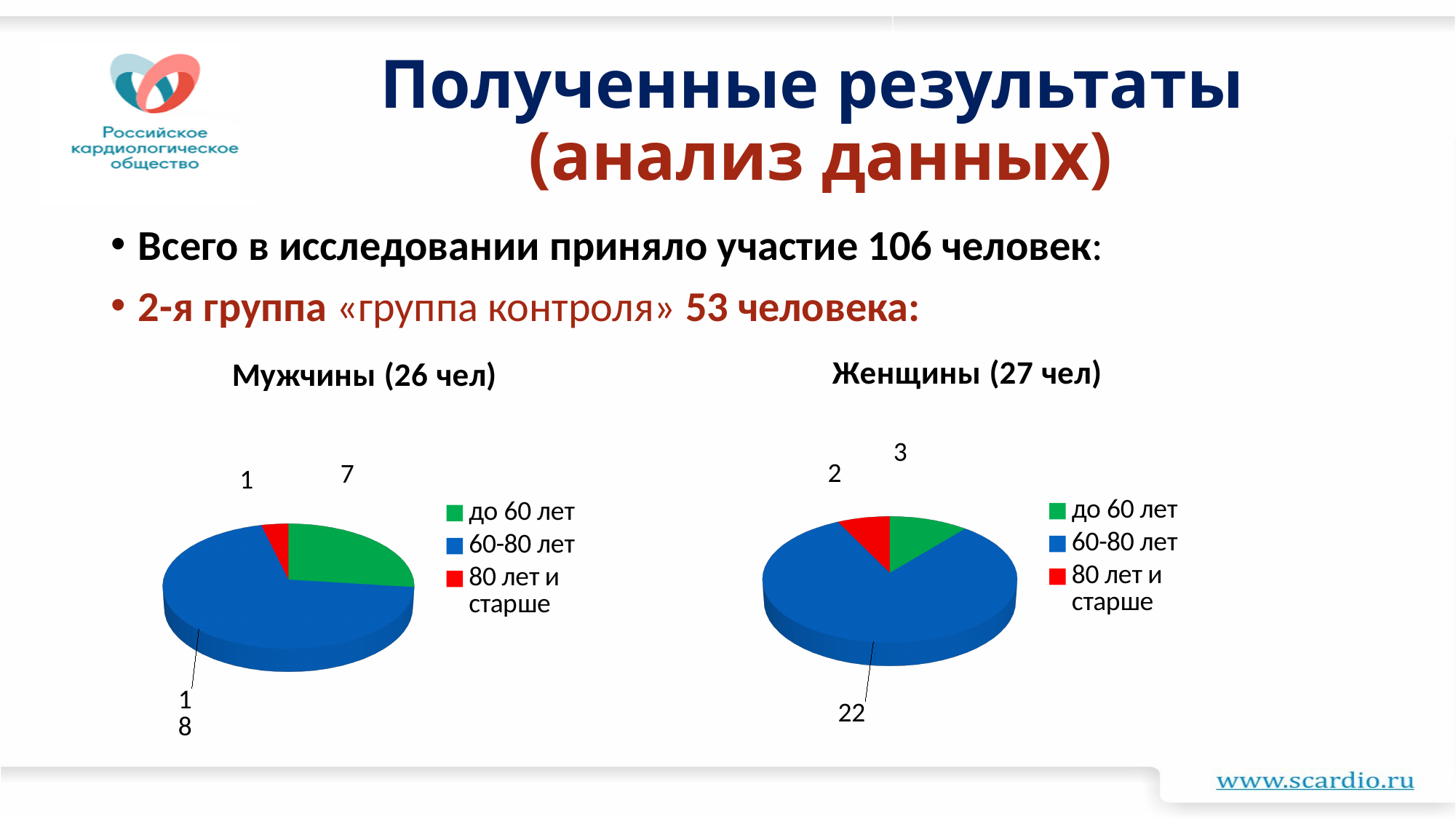
In the 'Женщины (27 чел)' chart, which age group has the smallest slice? 80 лет и старше In the 'Мужчины (26 чел)' chart, which age group has the largest slice? 60-80 лет Which is larger: the 'до 60 лет' value in the 'Мужчины (26 чел)' chart or the 'до 60 лет' value in the 'Женщины (27 чел)' chart? Мужчины (26 чел) In the 'Мужчины (26 чел)' chart, what is the value for the 'до 60 лет' slice? 7 In the 'Женщины (27 чел)' chart, what share of the total does the '60-80 лет' slice represent? 22 of 27 What type of chart is the 'Мужчины (26 чел)' chart? Pie chart In the 'Женщины (27 чел)' chart, what is the value for the '80 лет и старше' slice? 2 In the 'Мужчины (26 чел)' chart, what is the difference between the '60-80 лет' and 'до 60 лет' values? 11 In the 'Мужчины (26 чел)' chart, what colour represents the '80 лет и старше' category? Red In the 'Женщины (27 чел)' chart, what is the value for the '60-80 лет' slice? 22 In the 'Мужчины (26 чел)' chart, what is the value for the '60-80 лет' slice? 18 How many slices does the 'Женщины (27 чел)' chart have? 3